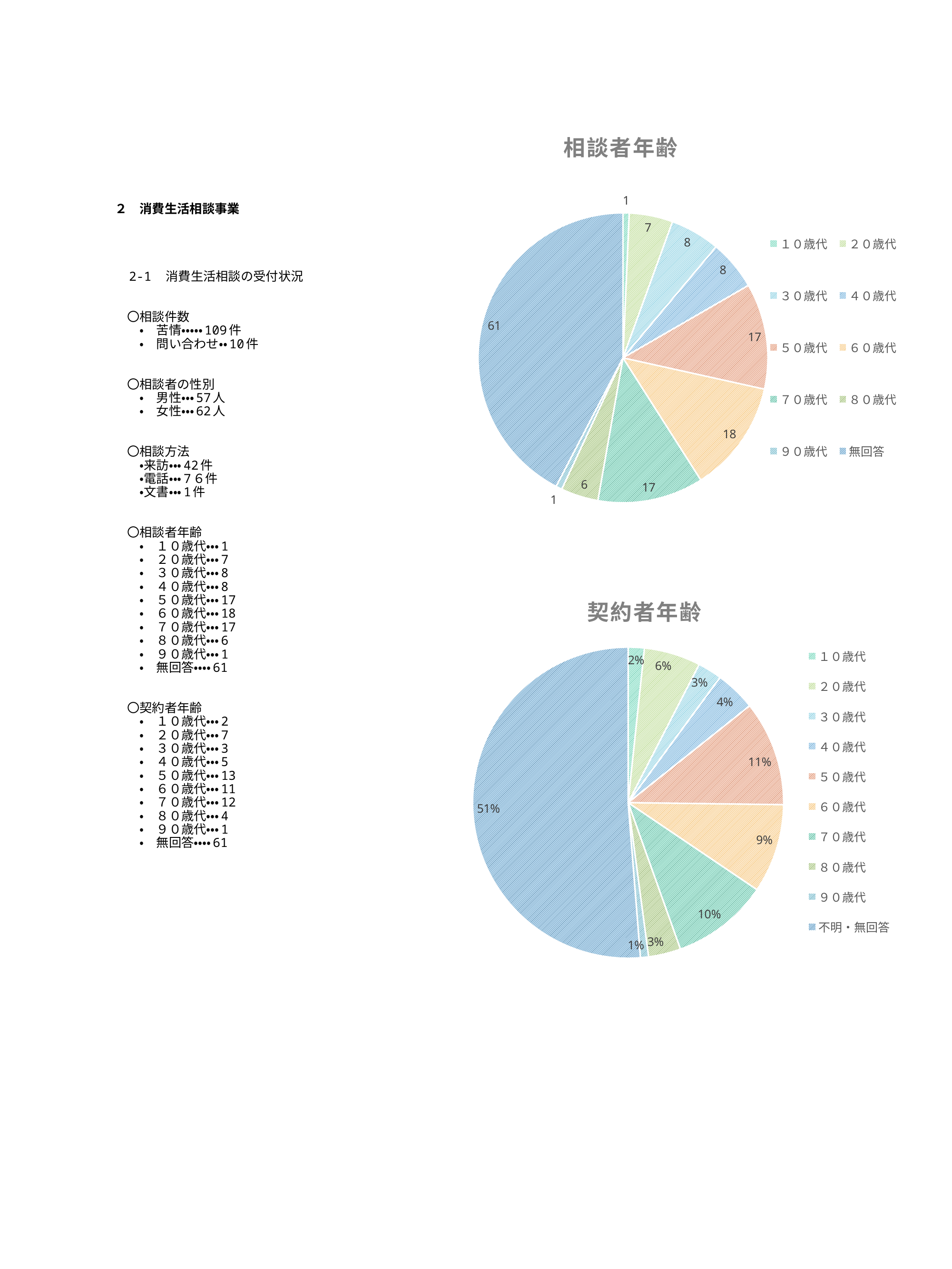
In the 契約者年齢 chart, what is the share for 不明・無回答? 51% In the 相談者年齢 chart, what is the value for 無回答? 61 In the 相談者年齢 chart, which category has the largest slice? 無回答 In the 相談者年齢 chart, what is the difference between the values for 60歳代 and 80歳代? 12 In the 契約者年齢 chart, which category has the smallest slice? 90歳代 How many slices does the 契約者年齢 pie chart have? 10 In the 相談者年齢 chart, which is larger, the value for 20歳代 or the value for 50歳代? 50歳代 In the 契約者年齢 chart, what is the share for 50歳代? 11% What kind of chart is the 相談者年齢 chart? pie chart How many entries does the legend of the 相談者年齢 chart list? 10 In the 相談者年齢 chart, what is the value for 60歳代? 18 In the 契約者年齢 chart, which is larger, the share for 60歳代 or the share for 70歳代? 70歳代